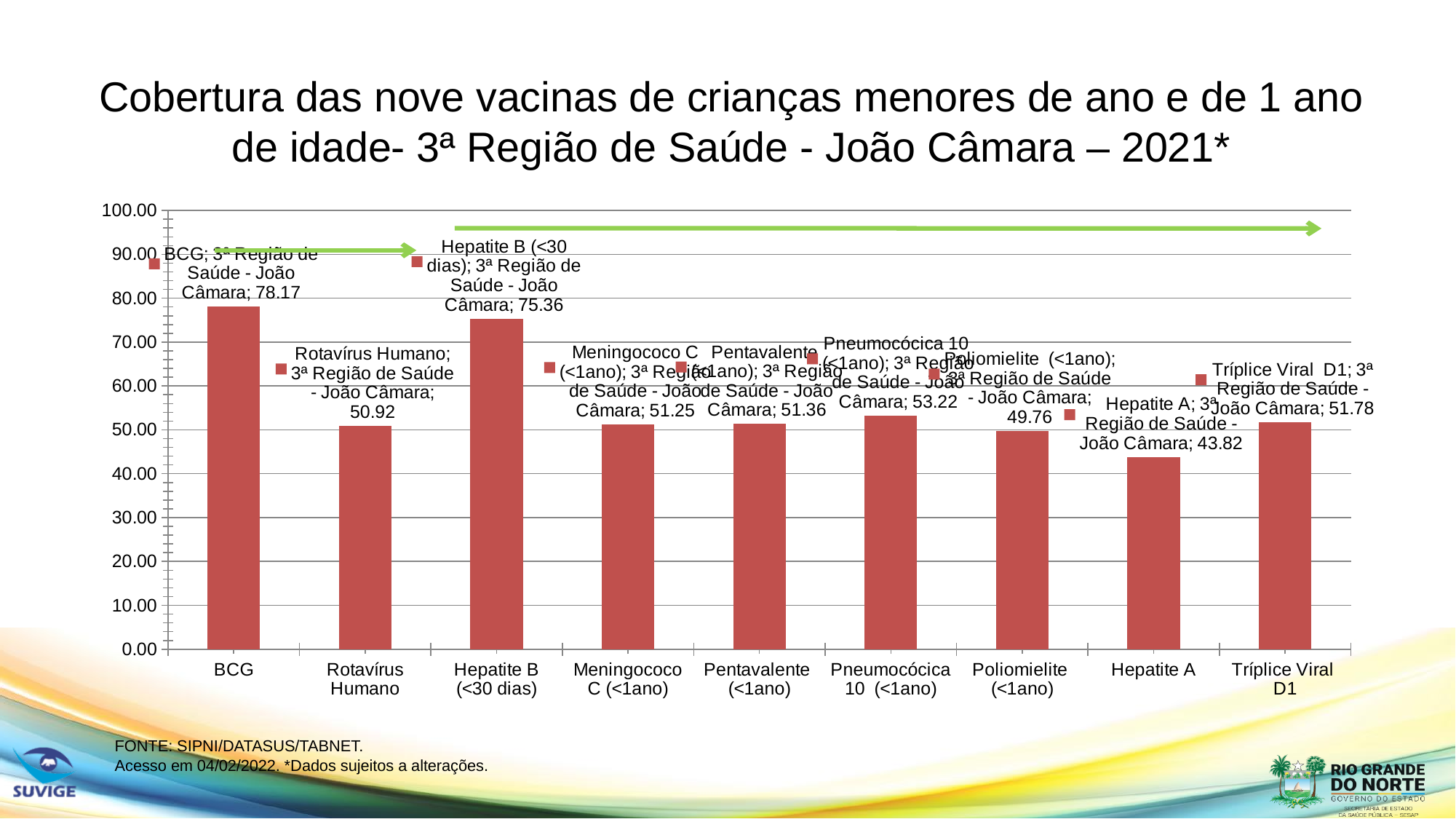
Is the value for Hepatite B (<30 dias) greater or less than 70.00? greater What is the value for Pneumocócica 10 (<1ano)? 53.22 Which vaccine has the highest coverage value? BCG Which is larger, the value for Pneumocócica 10 (<1ano) or the value for Poliomielite (<1ano)? Pneumocócica 10 (<1ano) What is the value for Tríplice Viral D1? 51.78 What is the value for Hepatite A? 43.82 Which vaccine has the lowest coverage value? Hepatite A What is the difference between the values for Rotavírus Humano and Hepatite A? 7.10 How many vaccines (categories) are shown on the x axis? 9 What is the value for BCG? 78.17 What is the difference between the values for BCG and Hepatite B (<30 dias)? 2.81 What kind of chart is shown on the slide? Bar chart